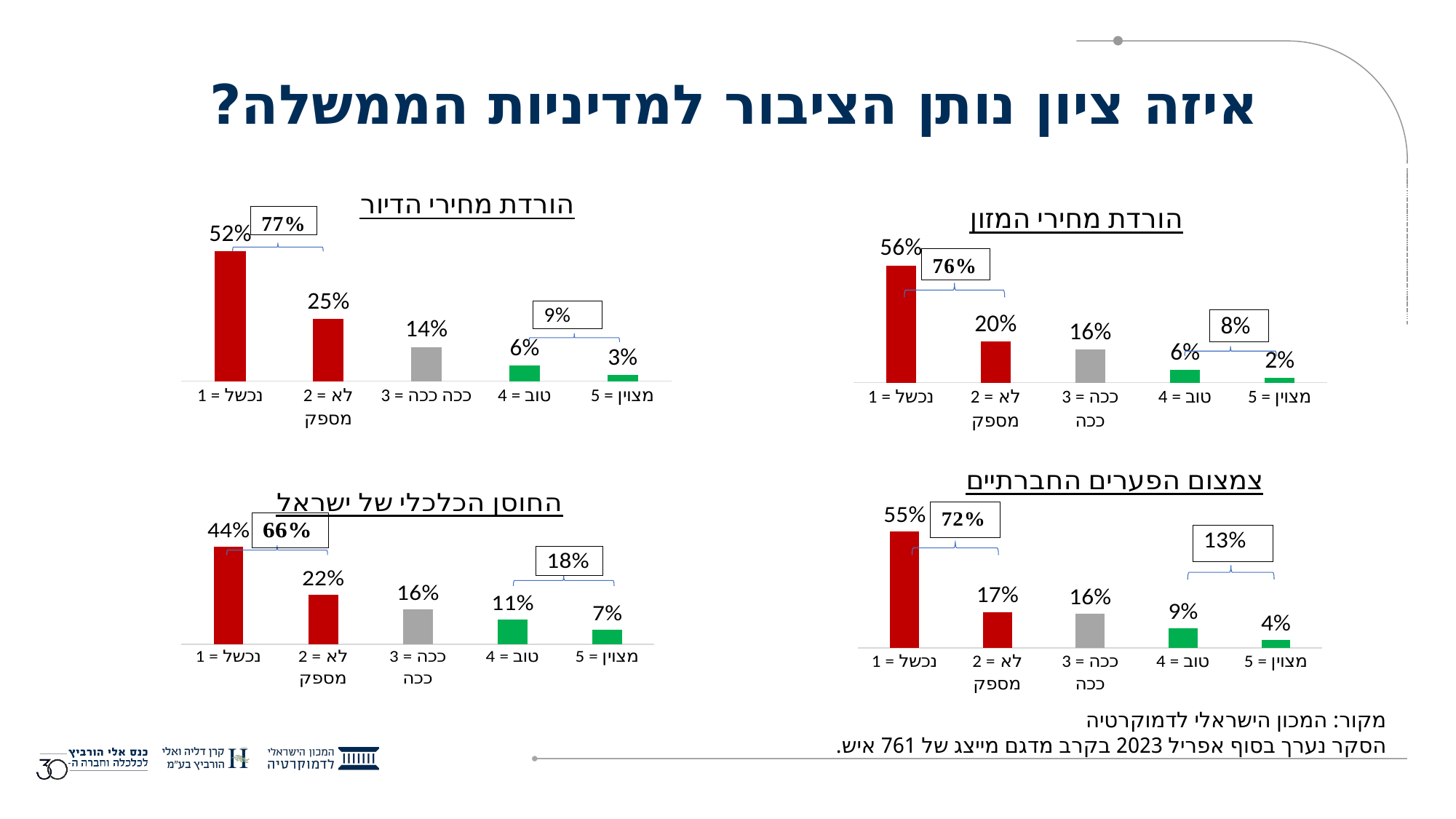
In the chart titled "הורדת מחירי הדיור" (top-left), what is the value for "1 = נכשל"? 52% In the chart titled "הורדת מחירי המזון" (top-right), what is the value for "5 = מצוין"? 2% In the chart titled "צמצום הפערים החברתיים" (bottom-right), which category has the highest value? 1 = נכשל In the chart titled "החוסן הכלכלי של ישראל" (bottom-left), what is the value for "4 = טוב"? 11% In the chart titled "הורדת מחירי הדיור" (top-left), what combined percentage is shown in the bracket label above the "4 = טוב" and "5 = מצוין" bars? 9% How many categories does the chart titled "צמצום הפערים החברתיים" (bottom-right) show? 5 In the chart titled "צמצום הפערים החברתיים" (bottom-right), do the values rise or fall from "1 = נכשל" to "5 = מצוין"? fall In the chart titled "הורדת מחירי הדיור" (top-left), which category has the lowest value? 5 = מצוין What kind of chart is the chart titled "הורדת מחירי הדיור" (top-left)? bar chart In the chart titled "החוסן הכלכלי של ישראל" (bottom-left), which is larger: the value for "3 = ככה ככה" or the value for "4 = טוב"? 3 = ככה ככה How many charts are shown on the slide? 4 In the chart titled "הורדת מחירי המזון" (top-right), what is the difference between the values for "1 = נכשל" and "2 = לא מספק"? 36%